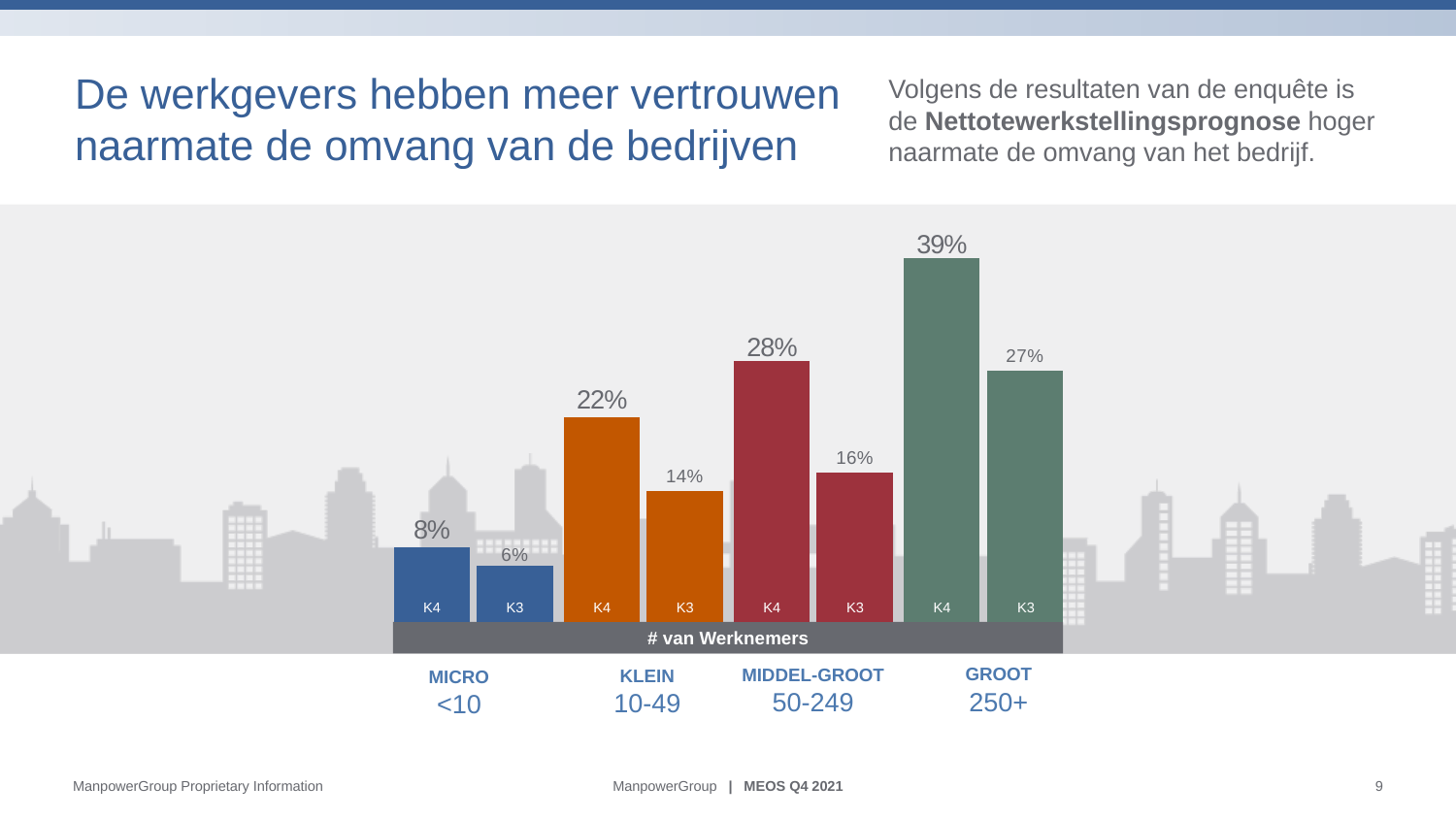
What kind of chart is shown on the slide? Bar chart What is the K4 value for the MICRO (<10) category? 8% What is the difference between the K4 values for KLEIN (10-49) and MICRO (<10)? 14 percentage points What is the K3 value for the KLEIN (10-49) category? 14% Do the K4 values rise or fall as company size increases from MICRO to GROOT? Rise Which is larger: the K3 value for MIDDEL-GROOT (50-249) or the K4 value for KLEIN (10-49)? K4 value for KLEIN (22%) What is the K3 value for the GROOT (250+) category? 27% What is the difference between the K4 and K3 values for the GROOT (250+) category? 12 percentage points How many company size categories are shown on the chart? 4 What is the K4 value for the MIDDEL-GROOT (50-249) category? 28% Which company size category has the highest K4 value? GROOT (250+) Which company size category has the lowest K3 value? MICRO (<10)